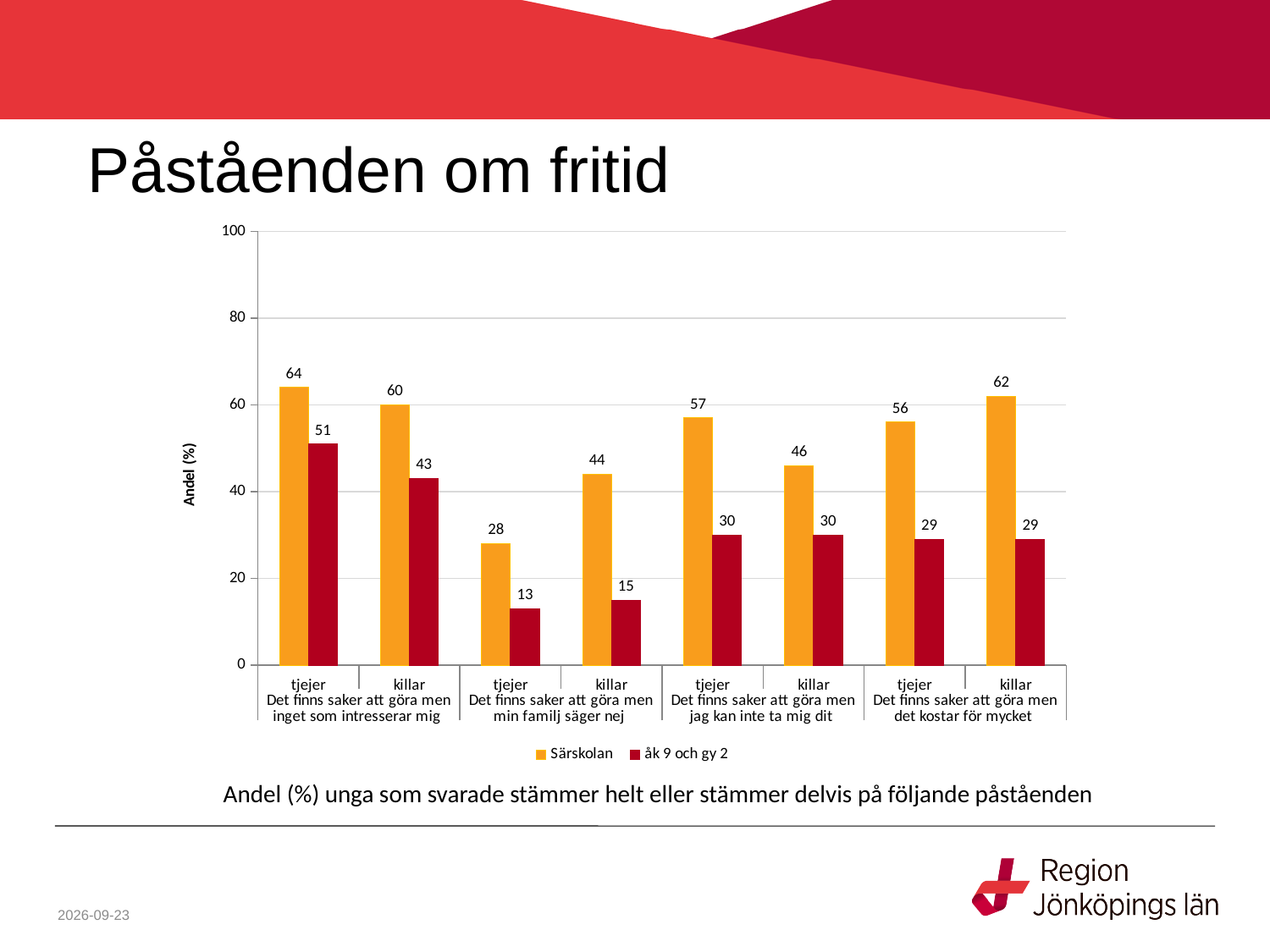
What is the Särskolan value for tjejer under "Det finns saker att göra men inget som intresserar mig"? 64 For killar under "Det finns saker att göra men inget som intresserar mig", which series has the larger value, Särskolan or åk 9 och gy 2? Särskolan What is the Särskolan value for killar under "Det finns saker att göra men det kostar för mycket"? 62 Is the Särskolan value for tjejer under "Det finns saker att göra men min familj säger nej" greater or less than 40? less How many bars are plotted for the Särskolan series? 8 What is the difference between the Särskolan and åk 9 och gy 2 values for tjejer under "Det finns saker att göra men jag kan inte ta mig dit"? 27 How many series does the legend list? 2 Which category has the lowest åk 9 och gy 2 value? tjejer, Det finns saker att göra men min familj säger nej What kind of chart is shown on the slide? bar chart What is the label of the y axis? Andel (%) Which category has the highest Särskolan value? tjejer, Det finns saker att göra men inget som intresserar mig What is the åk 9 och gy 2 value for killar under "Det finns saker att göra men min familj säger nej"? 15